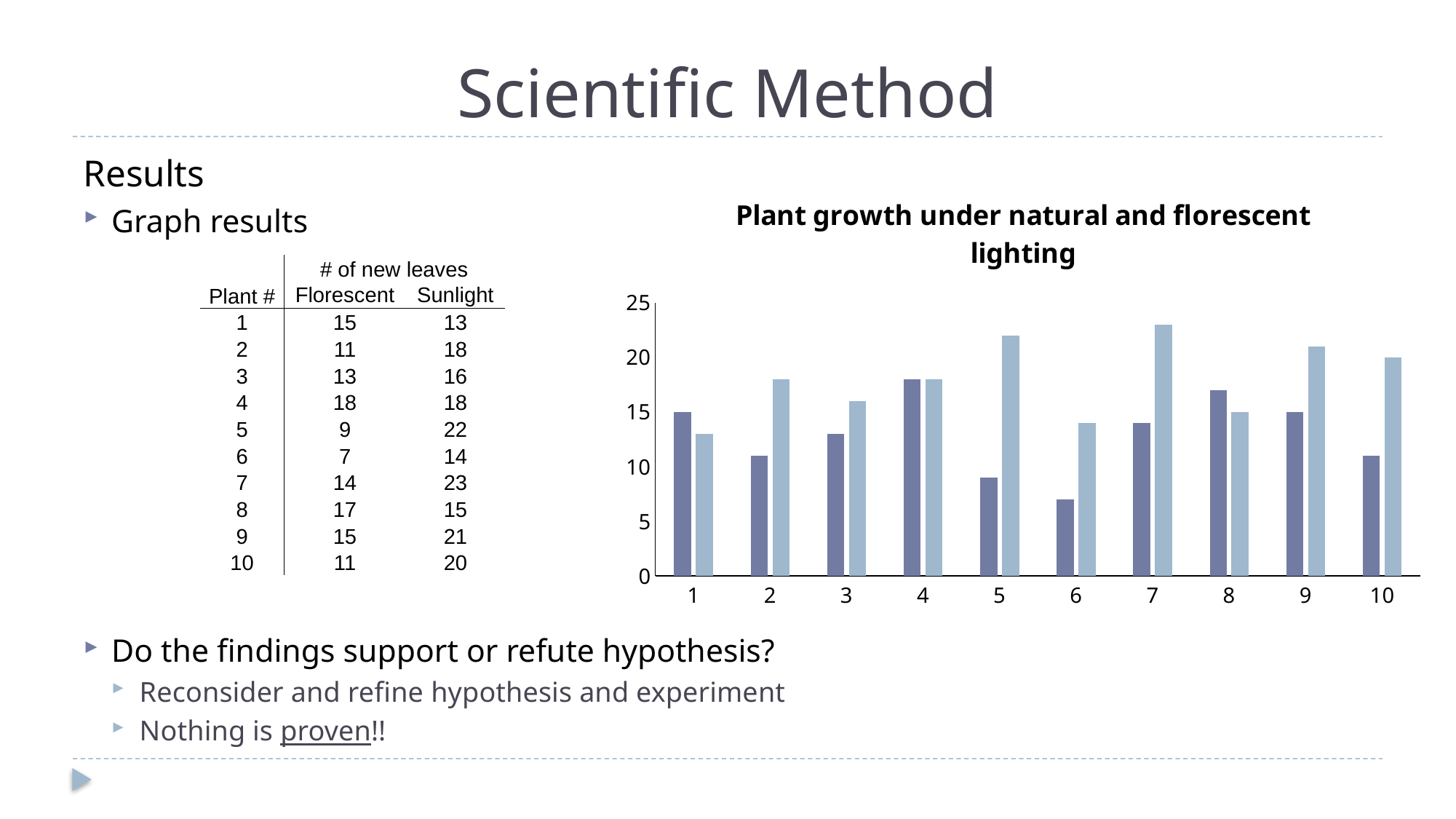
How many plants (categories) are shown on the x axis of the chart? 10 Is the value of the darker bar for plant 6 greater or less than 10? less What is the value of the darker bar for plant 1? 15 For plant 8, which bar is taller, the darker bar or the lighter bar? the darker bar What kind of chart is shown on the slide? bar chart Which plant has the shortest darker bar? 6 Is the value of the lighter bar for plant 5 greater or less than 20? greater For plant 2, which bar is taller, the darker bar or the lighter bar? the lighter bar What is the title of the chart? Plant growth under natural and florescent lighting What is the value of the lighter bar for plant 8? 15 Using the table values, what is the difference between the Sunlight and Florescent values for plant 5? 13 What is the value of the lighter bar for plant 10? 20